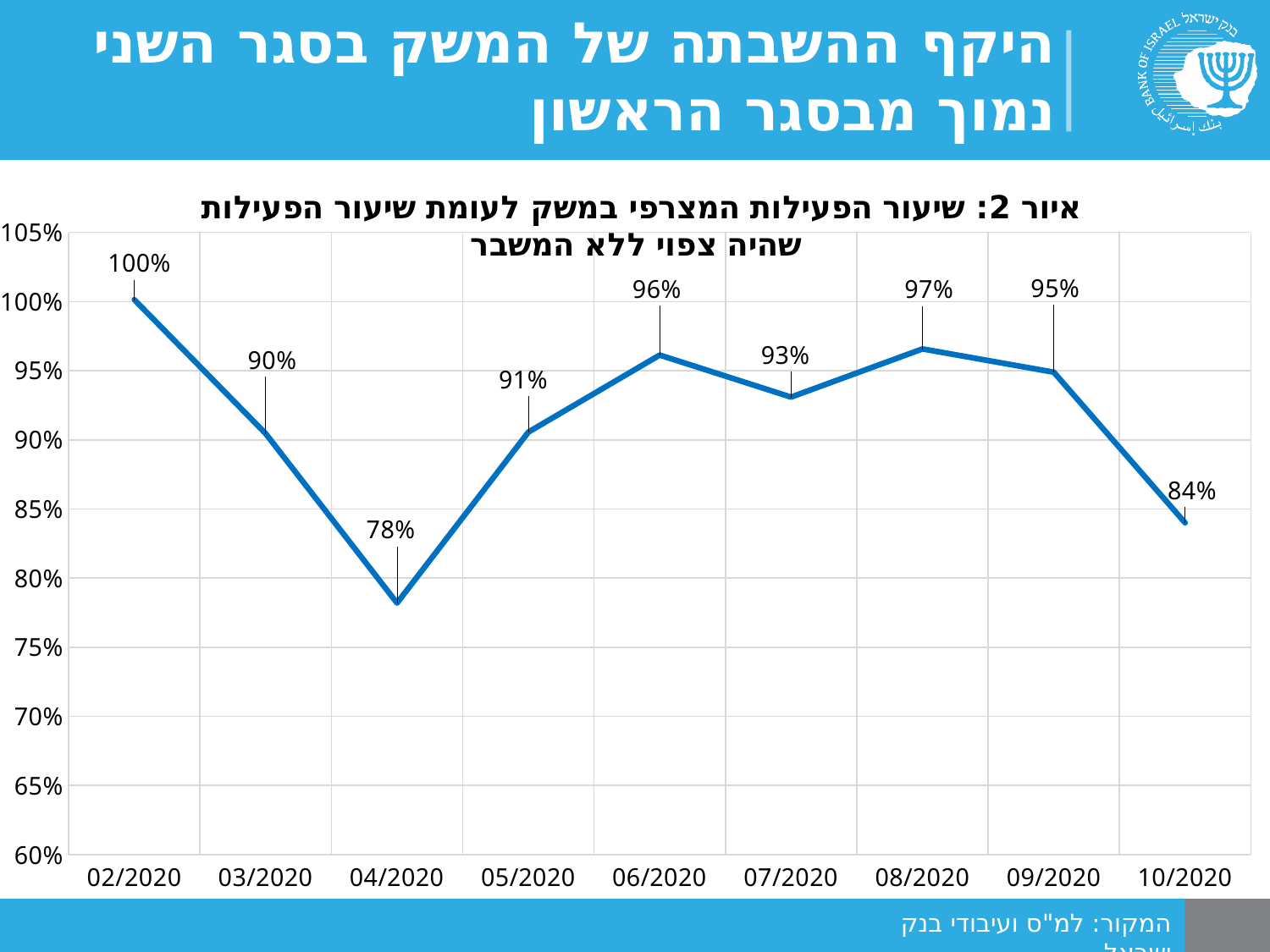
How many months are plotted on the x axis? 9 Does the value rise or fall from 09/2020 to 10/2020? fall What is the value for 04/2020? 78% What is the value for 10/2020? 84% Is the value for 04/2020 greater or less than 80%? less Which month has the highest value? 02/2020 What is the value for 08/2020? 97% What is the difference between the values for 02/2020 and 04/2020? 22% What kind of chart is shown on the slide? line chart What is the difference between the values for 09/2020 and 10/2020? 11% Which is larger, the value for 06/2020 or the value for 07/2020? 06/2020 Which month has the lowest value? 04/2020